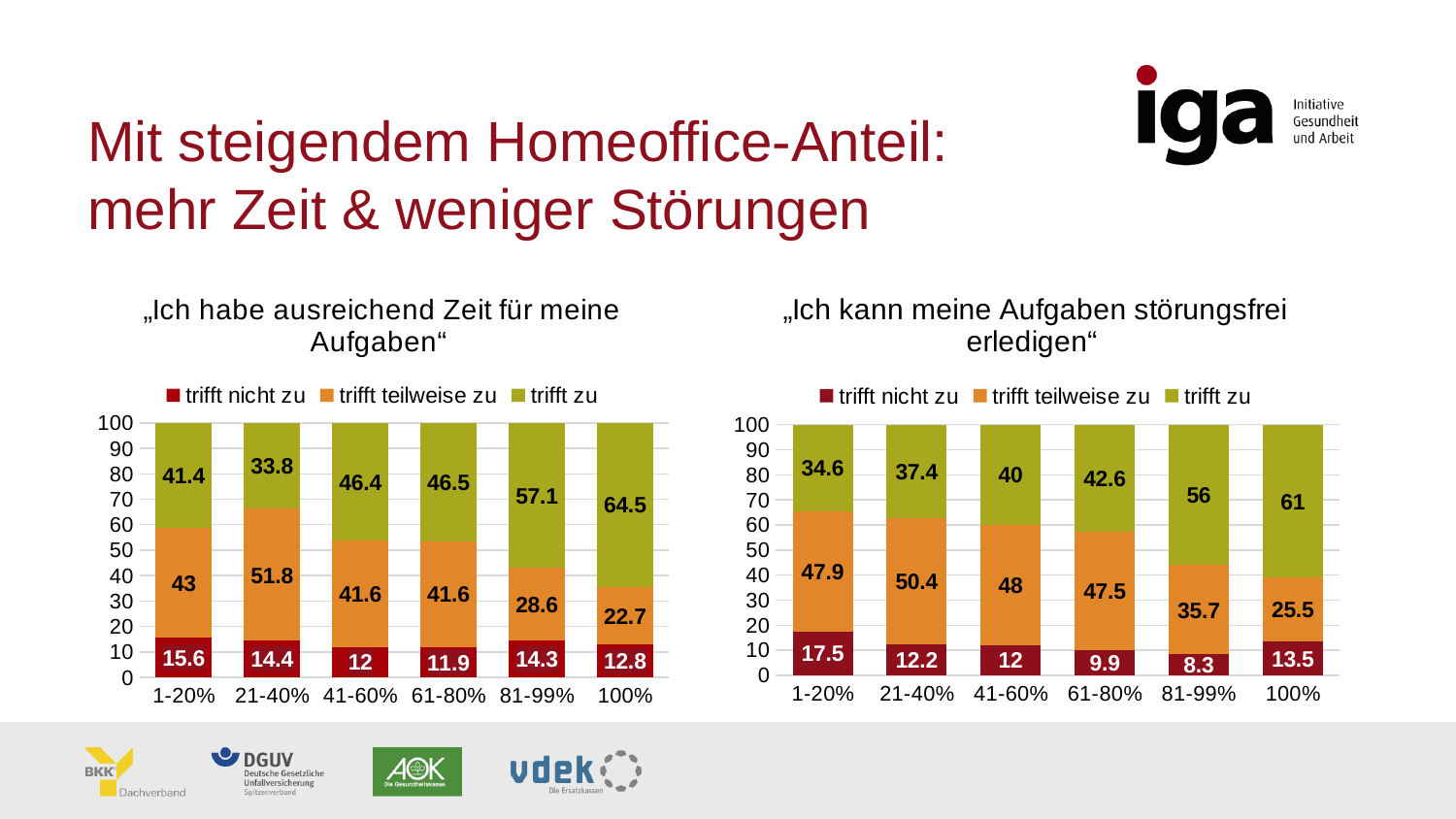
In the left chart ("Ich habe ausreichend Zeit für meine Aufgaben"), what is the total of the stacked bar for the 1-20% category? 100 What kind of chart is the left chart ("Ich habe ausreichend Zeit für meine Aufgaben")? Stacked bar chart In the right chart ("Ich kann meine Aufgaben störungsfrei erledigen"), what is the value of "trifft nicht zu" for the 81-99% category? 8.3 In the right chart ("Ich kann meine Aufgaben störungsfrei erledigen"), which category has the lowest "trifft nicht zu" value? 81-99% In the left chart ("Ich habe ausreichend Zeit für meine Aufgaben"), what is the difference between the "trifft teilweise zu" values for 21-40% and 100%? 29.1 In the right chart ("Ich kann meine Aufgaben störungsfrei erledigen"), do the "trifft zu" values rise or fall from 1-20% to 100%? Rise In the right chart ("Ich kann meine Aufgaben störungsfrei erledigen"), which is larger: the "trifft zu" value for 1-20% or for 81-99%? 81-99% How many categories are shown on the x axis of the left chart ("Ich habe ausreichend Zeit für meine Aufgaben")? 6 In the left chart ("Ich habe ausreichend Zeit für meine Aufgaben"), what is the value of "trifft zu" for the 100% category? 64.5 How many series does the legend of the right chart ("Ich kann meine Aufgaben störungsfrei erledigen") list? 3 In the right chart ("Ich kann meine Aufgaben störungsfrei erledigen"), what is the value of "trifft teilweise zu" for the 21-40% category? 50.4 In the left chart ("Ich habe ausreichend Zeit für meine Aufgaben"), which category has the highest "trifft zu" value? 100%